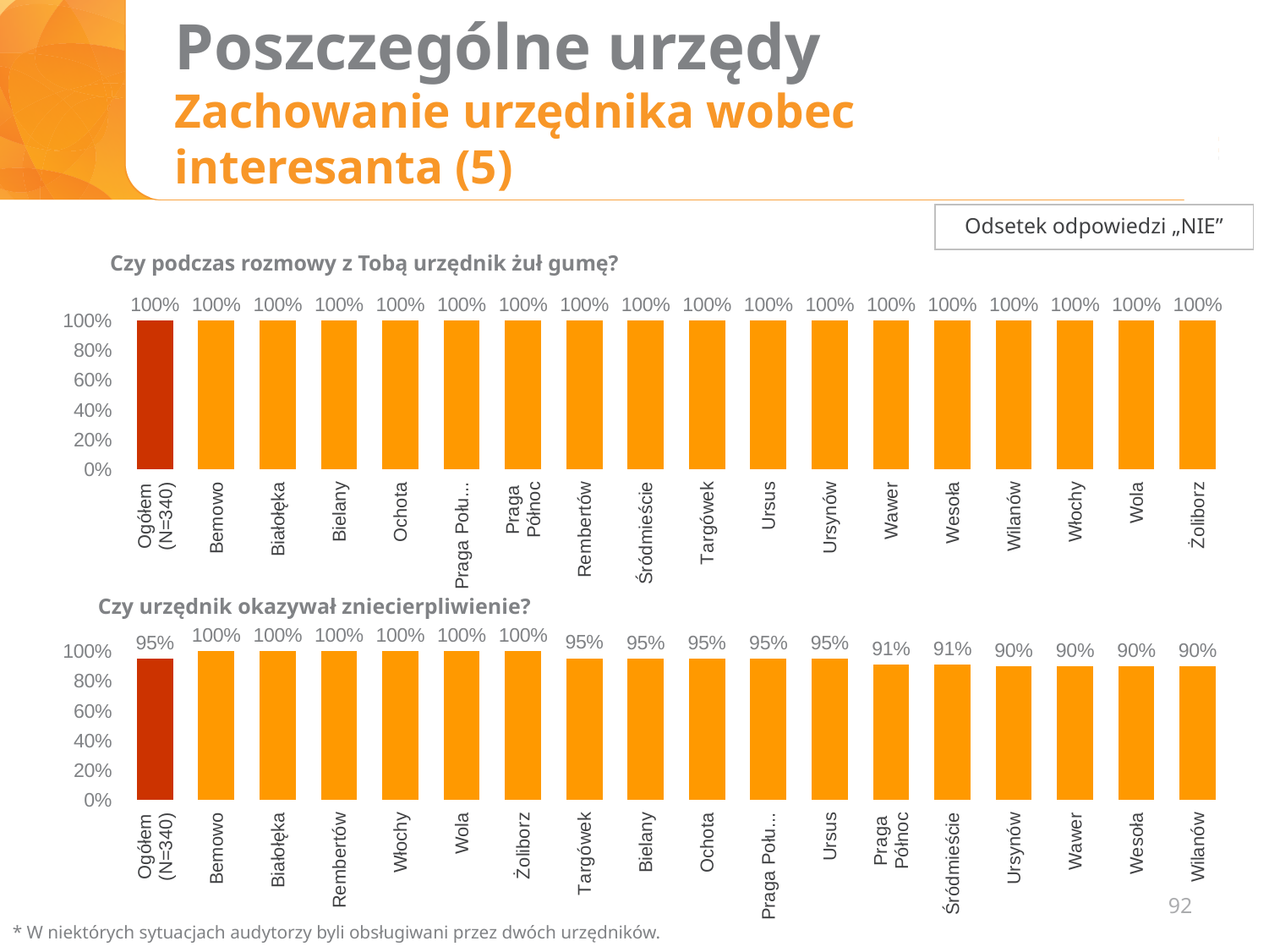
What kind of chart is the chart titled "Czy urzędnik okazywał zniecierpliwienie?"? Bar chart In the chart titled "Czy urzędnik okazywał zniecierpliwienie?", which is larger, the value for Rembertów or the value for Ursynów? Rembertów How many categories are shown in the chart titled "Czy podczas rozmowy z Tobą urzędnik żuł gumę?"? 18 Which category is shown with a darker red bar in both charts on the slide? Ogółem (N=340) In the chart titled "Czy urzędnik okazywał zniecierpliwienie?", what is the lowest value shown? 90% In the chart titled "Czy podczas rozmowy z Tobą urzędnik żuł gumę?", what is the value for Targówek? 100% In the chart titled "Czy urzędnik okazywał zniecierpliwienie?", do the values rise or fall from left to right along the x axis? Fall In the chart titled "Czy urzędnik okazywał zniecierpliwienie?", what is the value for Śródmieście? 91% In the chart titled "Czy urzędnik okazywał zniecierpliwienie?", what is the difference between the values for Bemowo and Wilanów? 10 percentage points In the chart titled "Czy urzędnik okazywał zniecierpliwienie?", is the value for Wawer greater or less than 80%? greater In the chart titled "Czy urzędnik okazywał zniecierpliwienie?", what is the value for Wilanów? 90% In the chart titled "Czy urzędnik okazywał zniecierpliwienie?", what is the value for Ogółem (N=340)? 95%